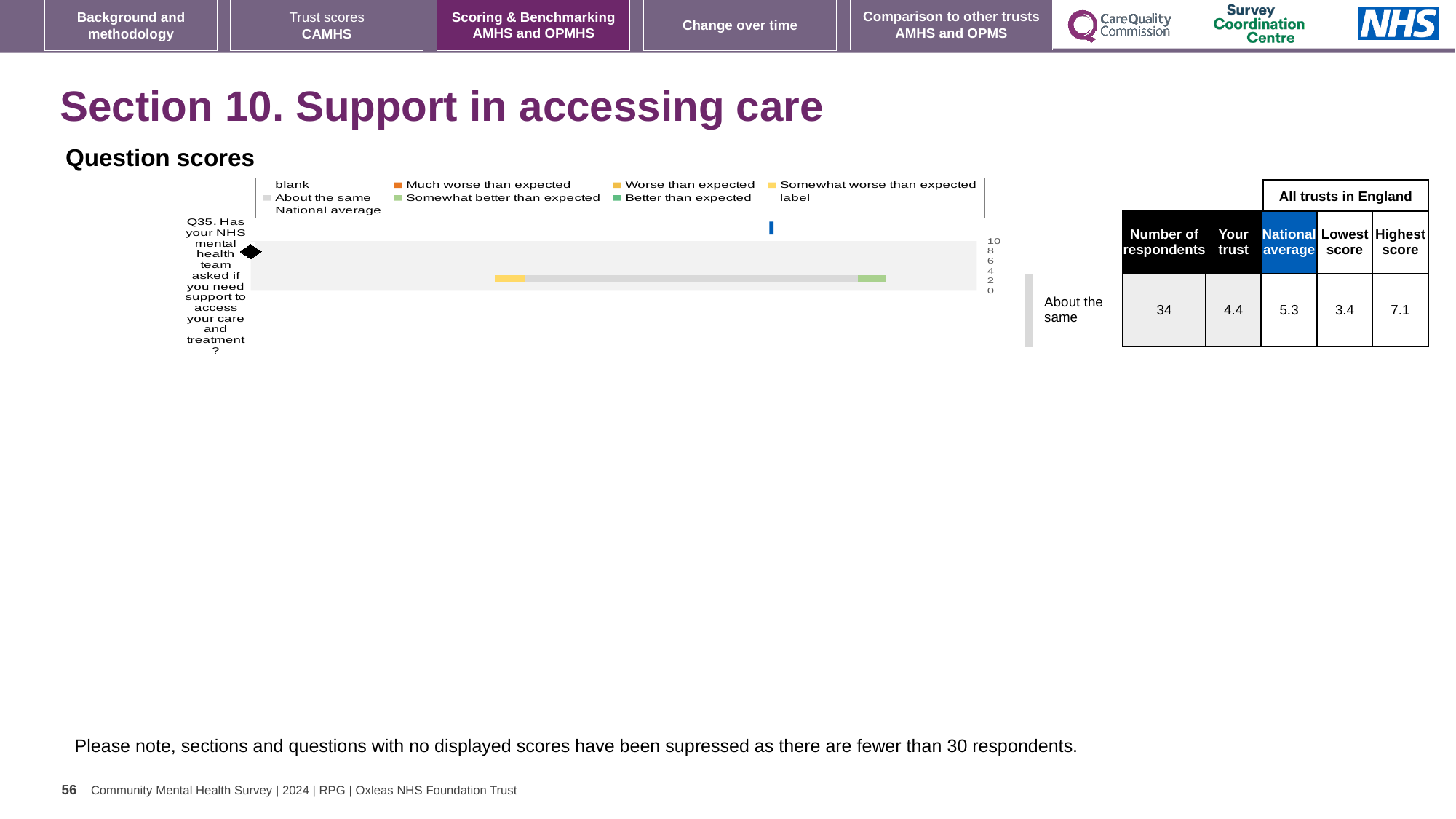
How many entries does the legend of the Question scores chart list? 9 What kind of chart is used to show the Q35 question score? bar chart What is the National average score for Q35 shown beside the Question scores chart? 5.3 What benchmark category is shown next to the Q35 bar in the Question scores chart? About the same What is the Lowest score among all trusts in England for Q35? 3.4 What is the Highest score among all trusts in England for Q35? 7.1 What is the difference between the Highest score and the Lowest score for Q35? 3.7 How many questions are plotted in the Question scores chart? 1 How many respondents answered Q35? 34 What is the 'Your trust' score for Q35 shown beside the Question scores chart? 4.4 Which is larger for Q35, the 'Your trust' score or the National average? National average Which question is plotted in the Question scores chart? Q35. Has your NHS mental health team asked if you need support to access your care and treatment?